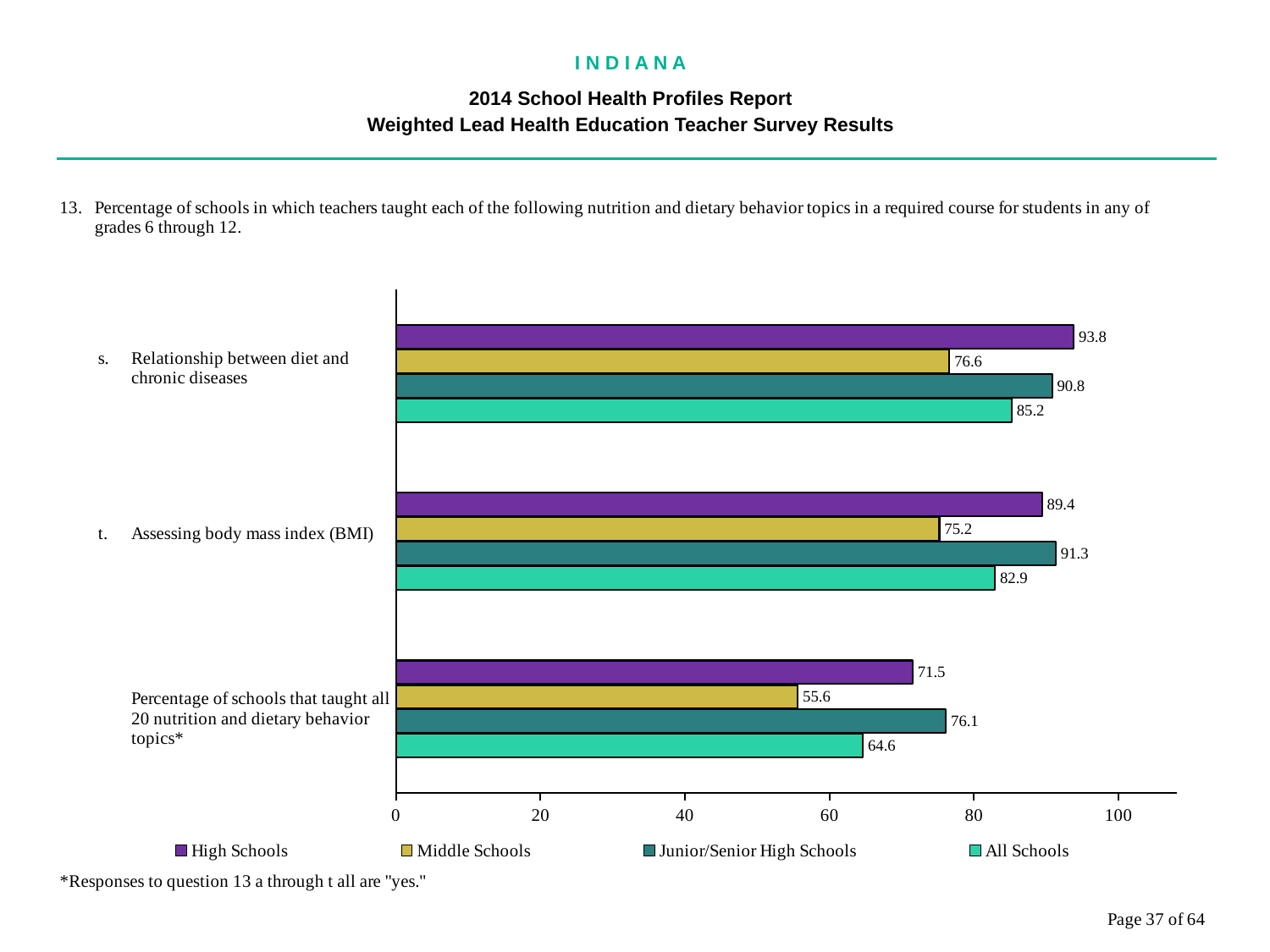
How many series does the legend list? 4 How many topic categories are shown in the chart? 3 Is the Middle Schools value for 'Percentage of schools that taught all 20 nutrition and dietary behavior topics' greater or less than 60? less What is the difference between the High Schools and Middle Schools values for 'Relationship between diet and chronic diseases'? 17.2 What is the value for Middle Schools for 'Assessing body mass index (BMI)'? 75.2 What kind of chart is shown on the slide? bar chart Which series has the lowest value for 'Percentage of schools that taught all 20 nutrition and dietary behavior topics'? Middle Schools Which is larger for 'Assessing body mass index (BMI)': the High Schools value or the Junior/Senior High Schools value? Junior/Senior High Schools Which series has the highest value for 'Assessing body mass index (BMI)'? Junior/Senior High Schools What is the value for High Schools for 'Relationship between diet and chronic diseases'? 93.8 Which colour represents All Schools in the legend? light green What is the value for All Schools for 'Percentage of schools that taught all 20 nutrition and dietary behavior topics'? 64.6